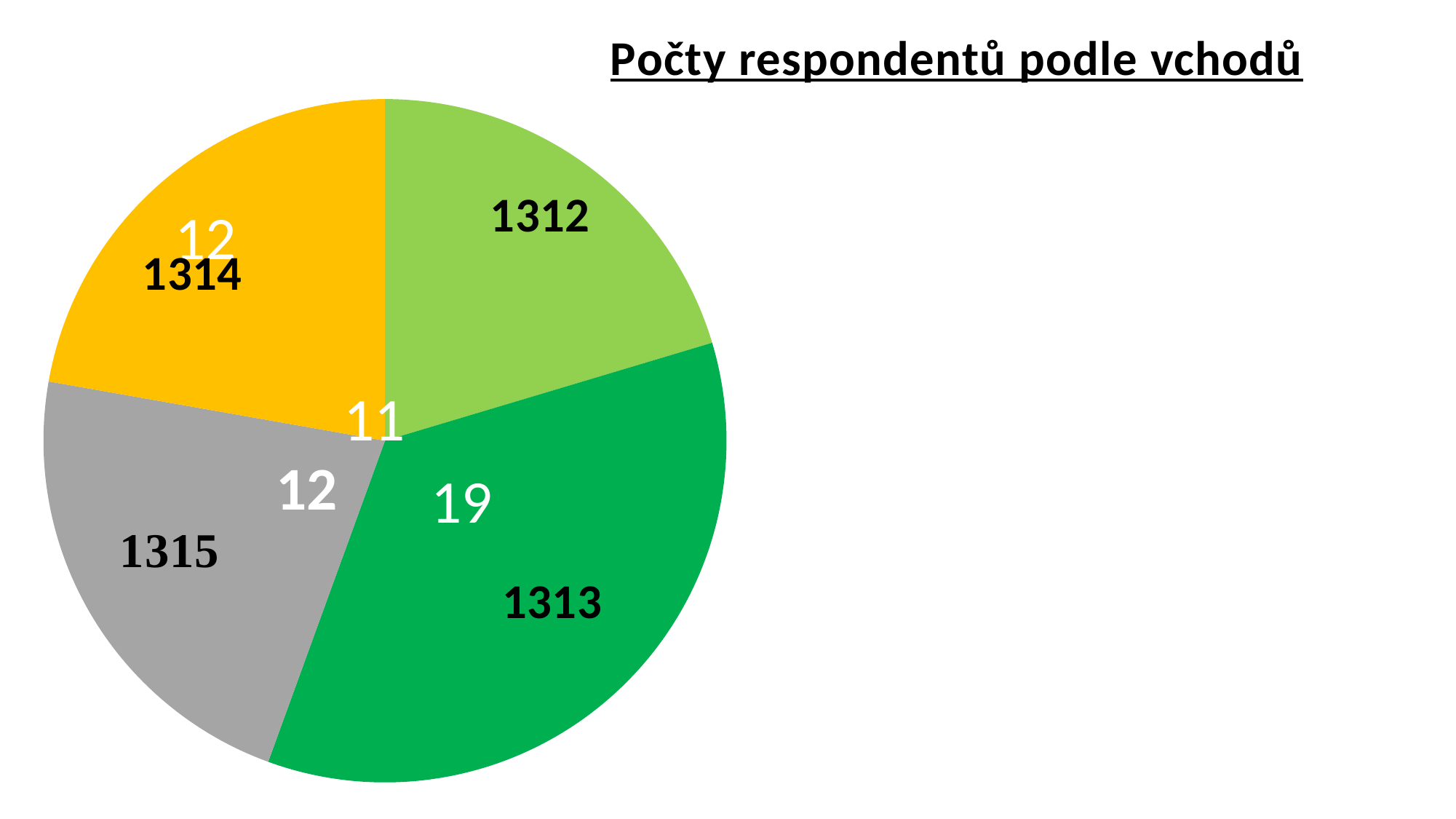
How many slices does the pie chart have? 4 What is the difference between the values for 1313 and 1312? 8 What is the value for entrance 1315? 12 What is the value for entrance 1314? 12 What is the difference between the values for 1313 and 1314? 7 What is the value for entrance 1313 in the pie chart? 19 What is the title of the chart? Počty respondentů podle vchodů What kind of chart is shown on the slide? Pie chart What is the value for entrance 1312? 11 Which entrance has the highest number of respondents? 1313 Which entrance has the lowest number of respondents? 1312 Which has a larger value, 1313 or 1315? 1313